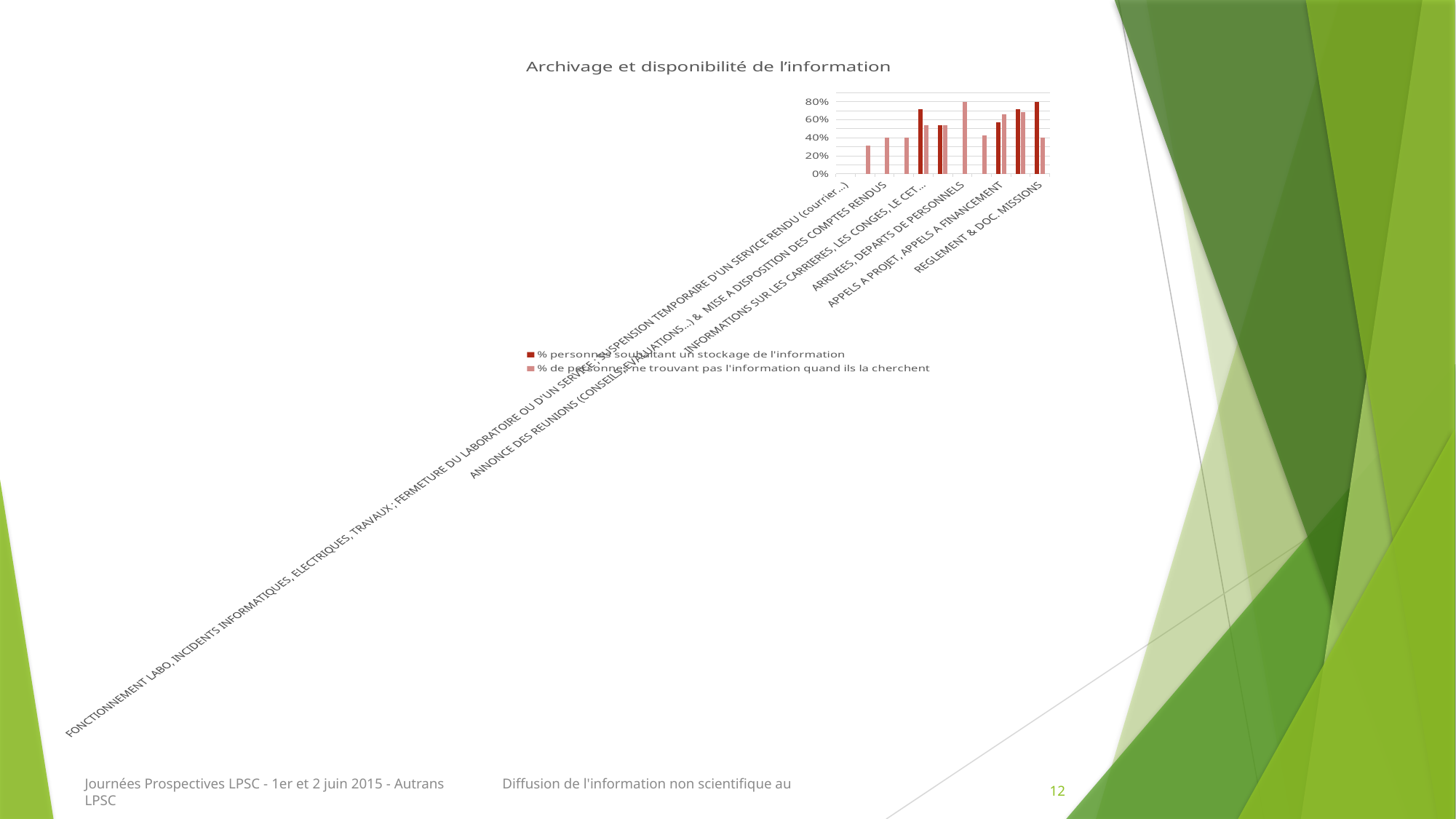
For REGLEMENT & DOC. MISSIONS, which series has the larger value: '% personnes souhaitant un stockage de l'information' or '% de personnes ne trouvant pas l'information quand ils la cherchent'? % personnes souhaitant un stockage de l'information What kind of chart is shown on the slide? bar chart Which series is shown in dark red in the chart? % personnes souhaitant un stockage de l'information Is the value of '% de personnes ne trouvant pas l'information quand ils la cherchent' for REGLEMENT & DOC. MISSIONS greater or less than 60%? less Is the value of '% personnes souhaitant un stockage de l'information' for REGLEMENT & DOC. MISSIONS greater or less than 60%? greater How many series does the legend of the chart list? 2 What is the title of the chart? Archivage et disponibilité de l'information